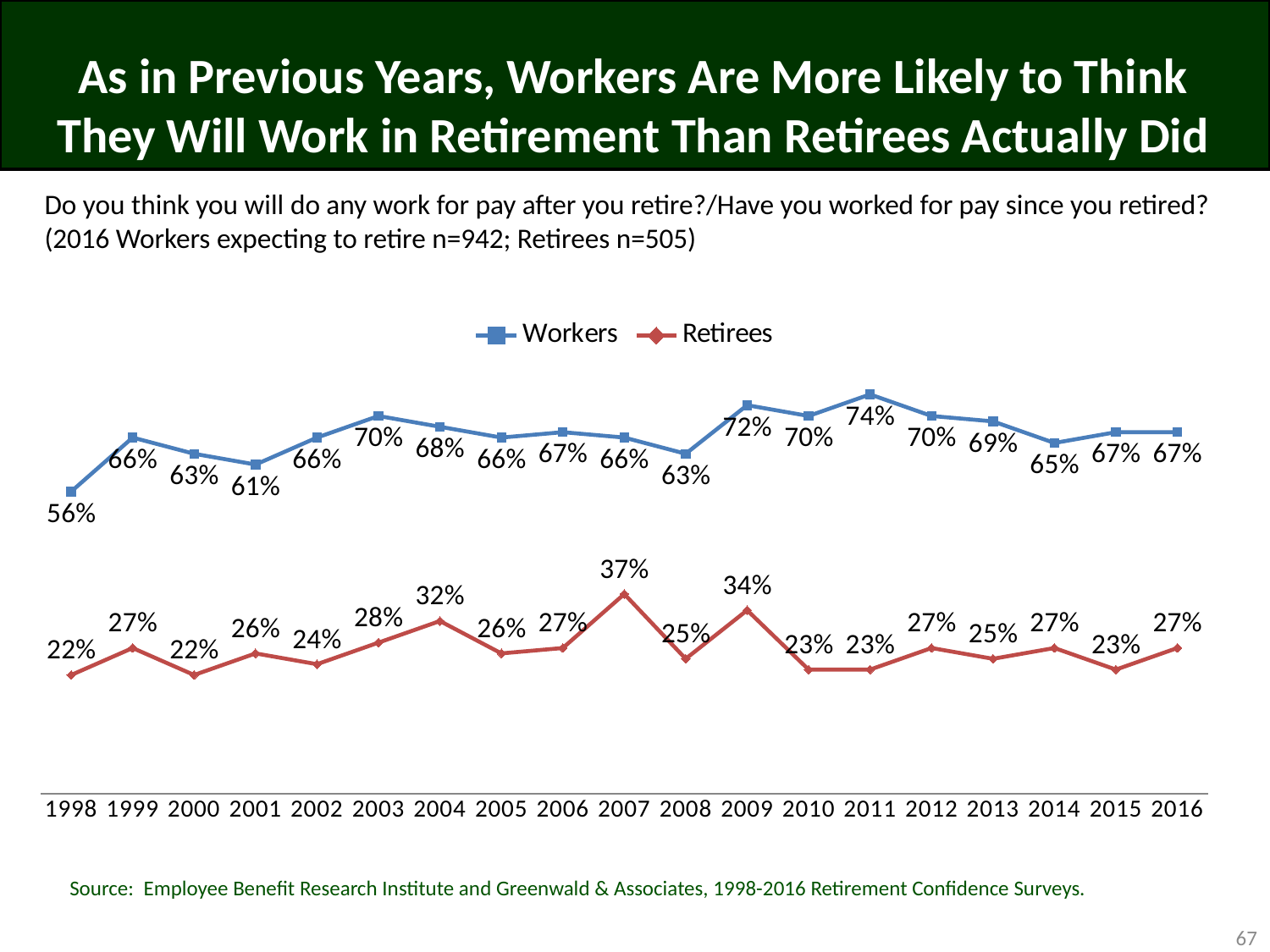
How many series does the legend list? 2 What is the value for Retirees in 2007? 37% What kind of chart is shown on the slide? Line chart What is the difference between the Workers and Retirees values in 2016? 40 percentage points Which is larger, the Retirees value in 2009 or the Retirees value in 2010? 2009 What is the value for Workers in 1998? 56% What is the value for Retirees in 2004? 32% In which year is the Workers value lowest? 1998 What is the value for Workers in 2011? 74% How many years are shown on the x axis? 19 In which year is the Retirees value highest? 2007 Which series is shown in red? Retirees